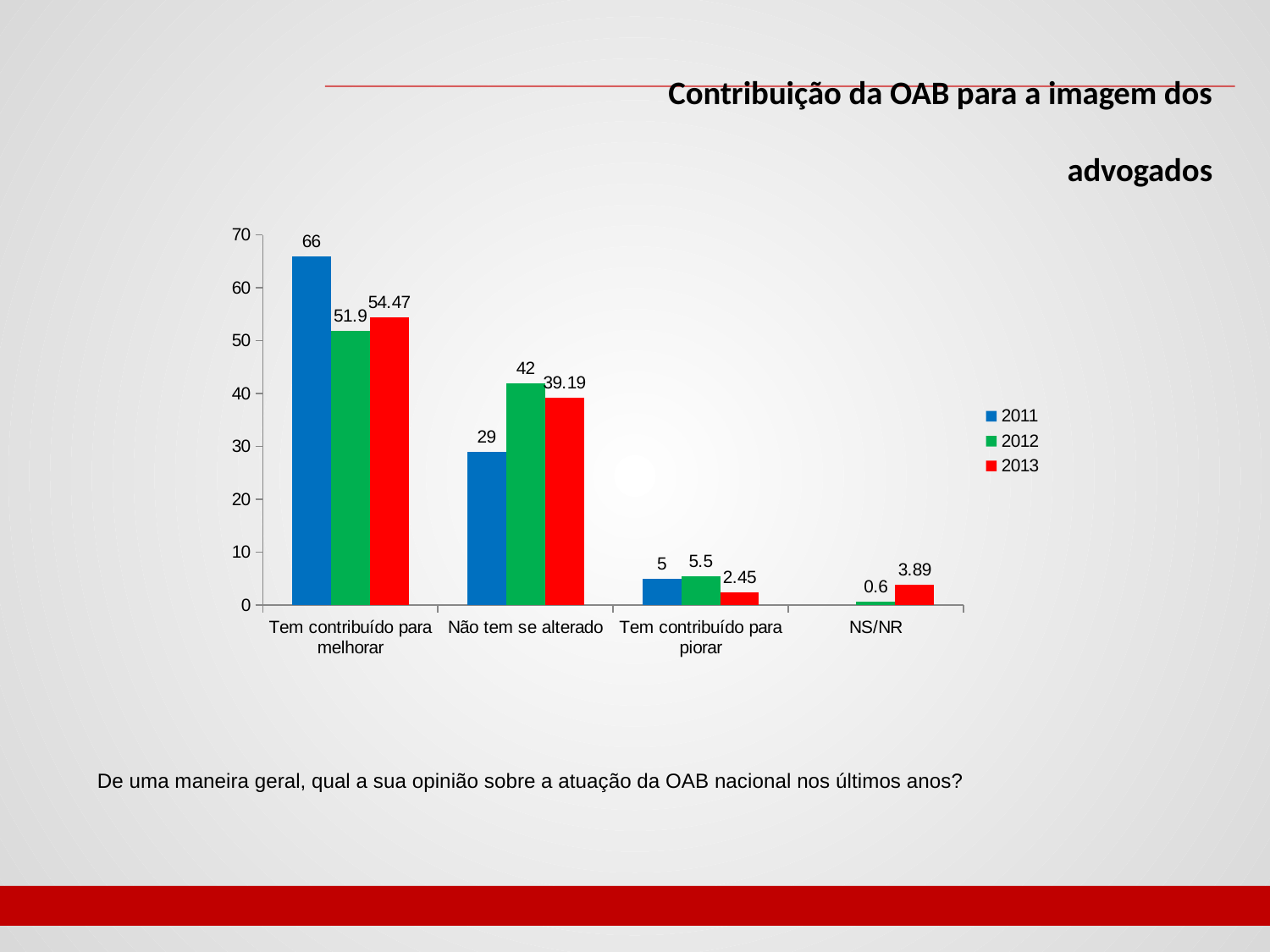
Which category has the lowest value for the 2013 series? Tem contribuído para piorar What kind of chart is shown on the slide? Bar chart What is the value for 2012 in the "NS/NR" category? 0.6 How many categories are shown on the x axis? 4 What is the value for 2011 in the "Tem contribuído para melhorar" category? 66 How many series does the legend list? 3 Which colour represents the 2013 series in the legend? Red What is the value for 2013 in the "Tem contribuído para piorar" category? 2.45 Which category has the highest value for the 2012 series? Tem contribuído para melhorar What is the value for 2013 in the "Não tem se alterado" category? 39.19 What is the difference between the 2011 and 2012 values in the "Tem contribuído para melhorar" category? 14.1 In the "Não tem se alterado" category, which series has the larger value, 2011 or 2012? 2012